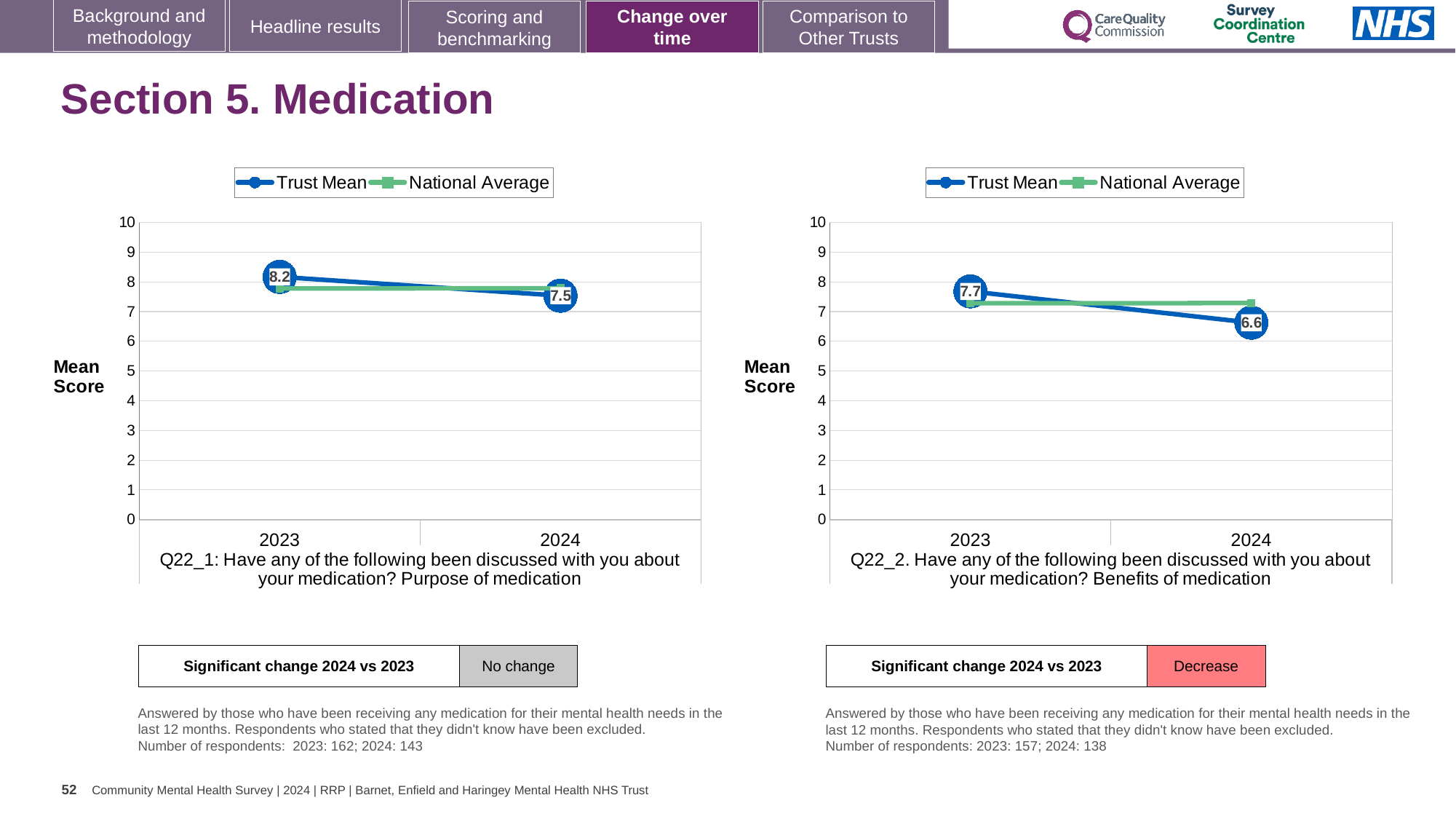
How many series does the legend of the Q22_2 chart (right) list? 2 In the Q22_2 chart (right), is the National Average for 2024 greater or less than 7? greater In the Q22_2 chart (right), does the Trust Mean rise or fall from 2023 to 2024? fall What type of chart is used for Q22_1 (left)? line chart In the Q22_1 chart (left), what is the Trust Mean for 2023? 8.2 In the Q22_1 chart (left), what is the Trust Mean for 2024? 7.5 In the Q22_2 chart (right), what is the difference between the Trust Mean in 2023 and in 2024? 1.1 In the Q22_1 chart (left), by how much did the Trust Mean fall from 2023 to 2024? 0.7 In the Q22_2 chart (right), which is larger in 2024: the Trust Mean or the National Average? National Average In the Q22_2 chart (right), what is the Trust Mean for 2023? 7.7 How many years are shown on the x axis of the Q22_1 chart (left)? 2 In the Q22_2 chart (right), what is the Trust Mean for 2024? 6.6